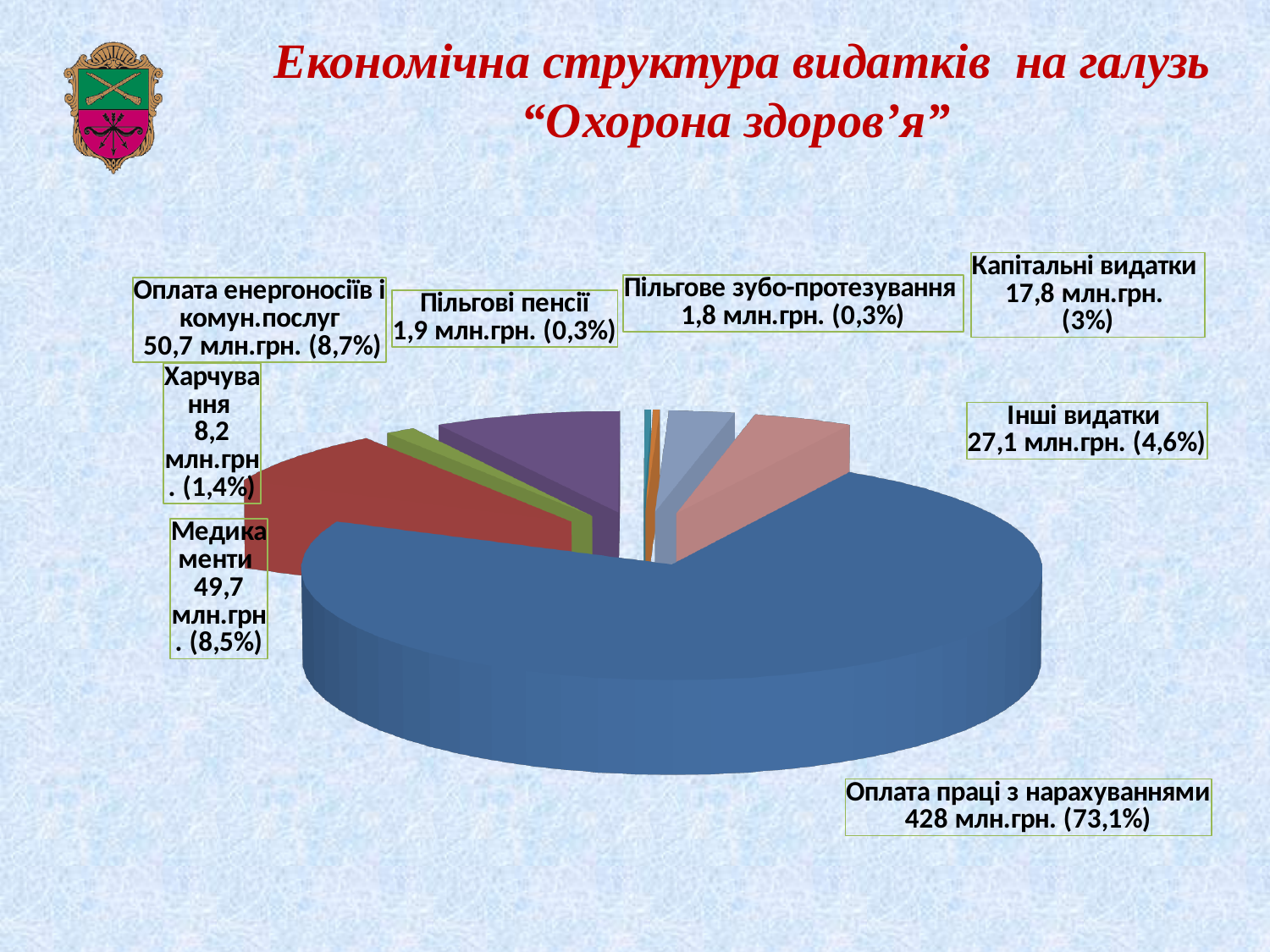
What is the difference between Оплата енергоносіїв і комун.послуг and Медикаменти? 1 млн.грн. What percentage is shown for Капітальні видатки? 3% How many categories are shown in the pie chart? 8 Which is larger, Оплата енергоносіїв і комун.послуг or Інші видатки? Оплата енергоносіїв і комун.послуг What is the title of the slide? Економічна структура видатків на галузь "Охорона здоров'я" Which category has the largest slice of the pie? Оплата праці з нарахуваннями What share of the pie does Оплата праці з нарахуваннями take? 73,1% What is the value for Оплата праці з нарахуваннями? 428 млн.грн. What kind of chart is shown on the slide? pie chart What is the difference between Інші видатки and Капітальні видатки? 9,3 млн.грн. What is the value for Медикаменти? 49,7 млн.грн. What is the value for Харчування? 8,2 млн.грн.